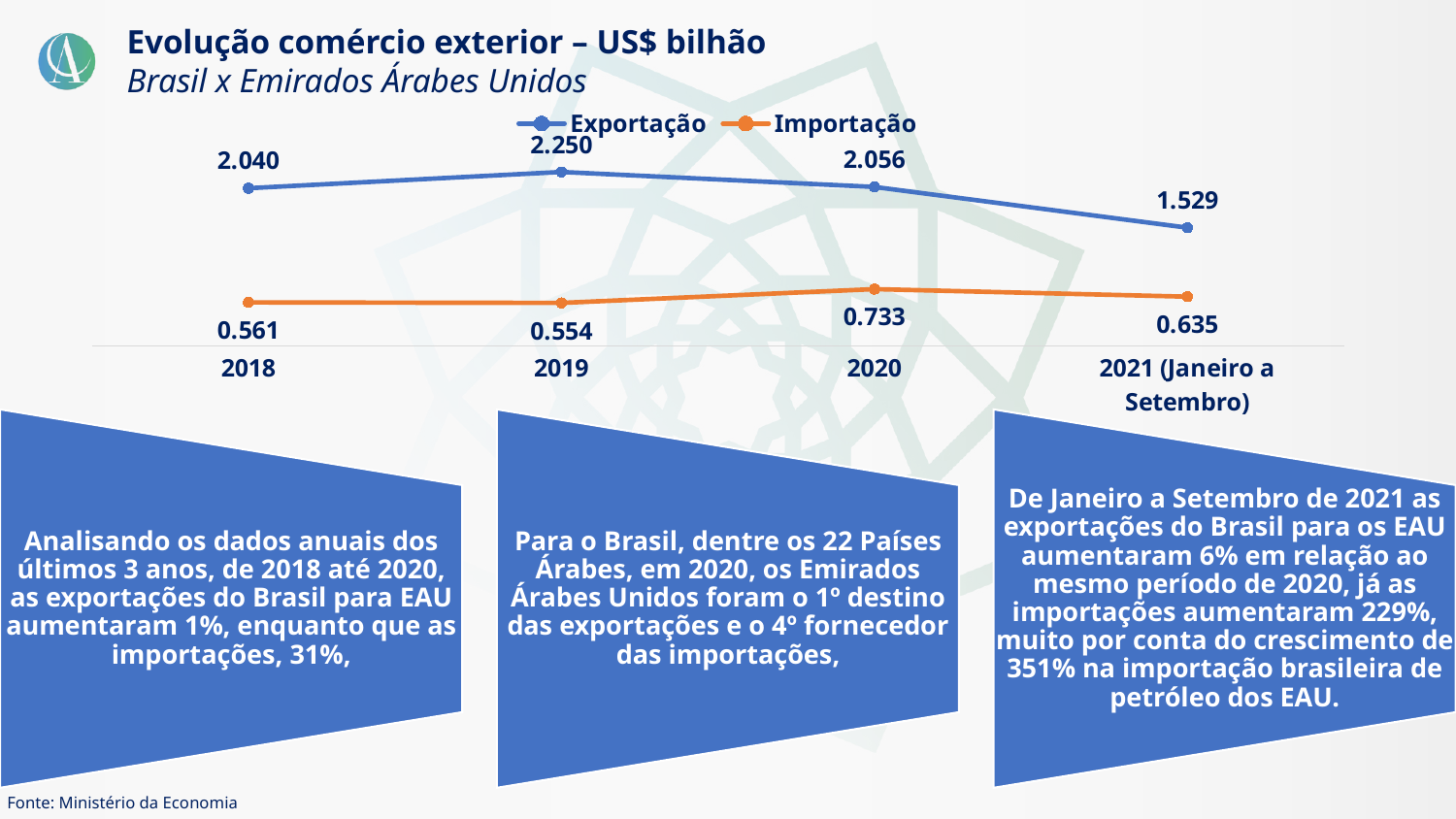
What is the difference between the Importação values for 2020 and 2019? 0.179 What is the difference between the Exportação values for 2019 and 2018? 0.210 Which is larger, the Exportação value for 2020 or for 2021 (Janeiro a Setembro)? 2020 In which period is the Importação value lowest? 2019 In which year is the Exportação value highest? 2019 What is the Exportação value for 2021 (Janeiro a Setembro)? 1.529 What kind of chart is shown on the slide? Line chart How many series does the legend list? 2 What is the Importação value for 2020? 0.733 What is the Importação value for 2018? 0.561 What is the Exportação value for 2019? 2.250 How many time periods are shown on the x axis? 4